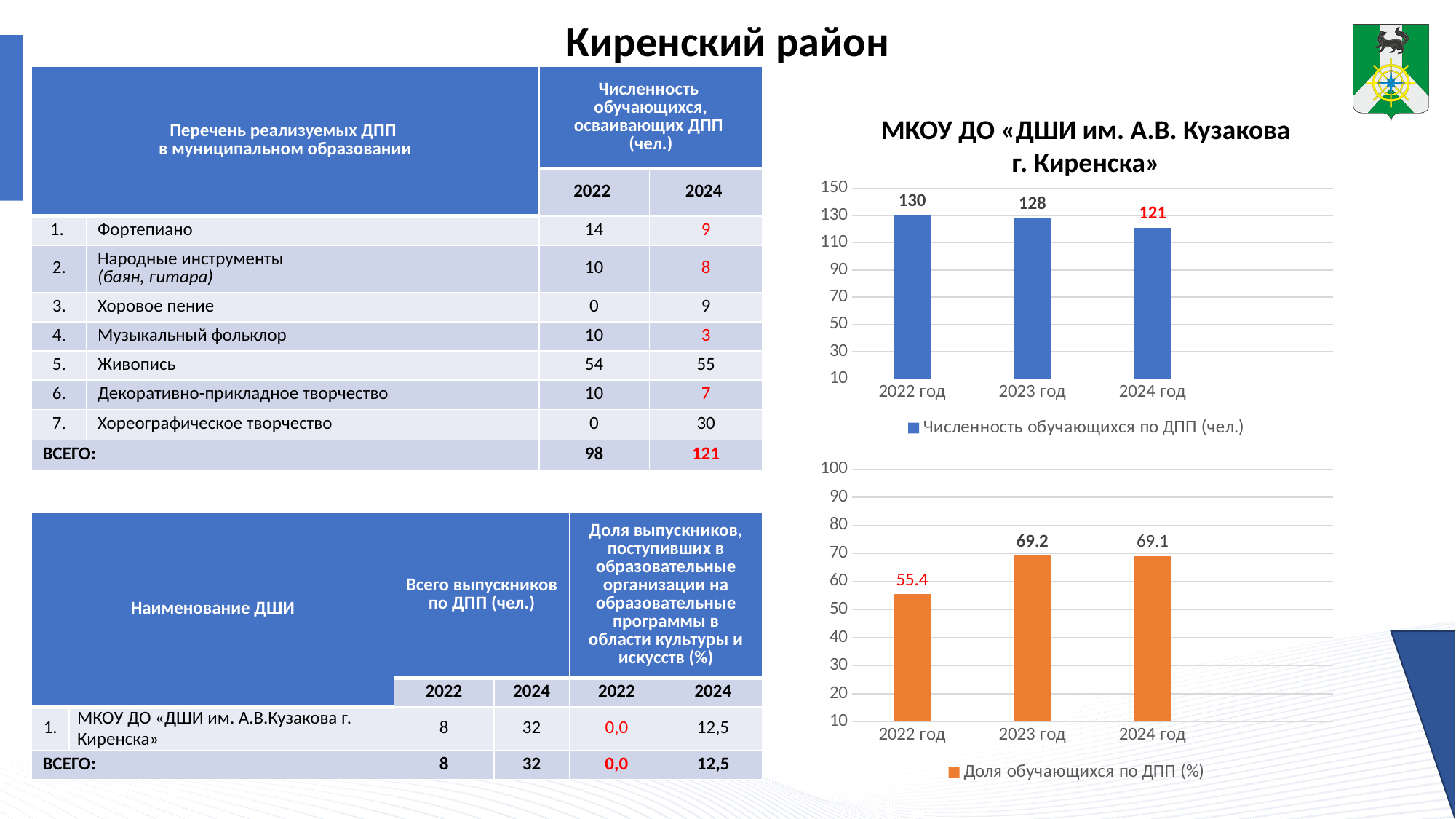
In the top chart, what is the difference between the values for 2022 год and 2024 год? 9 In the bottom chart, what is the difference between the values for 2023 год and 2022 год? 13.8 In the bottom chart, what is the value for 2023 год? 69.2 In the top chart, which year has the lowest value? 2024 год In the top chart, what is the value for 2022 год? 130 In the top chart, do the values rise or fall from 2022 год to 2024 год? fall In the bottom chart, what is the value for 2022 год? 55.4 In the top chart, what is the value for 2024 год? 121 In the bottom chart, which year has the lowest value? 2022 год In the bottom chart, is the value for 2022 год larger or smaller than the value for 2024 год? smaller What type of chart is the bottom chart? bar chart In the top chart, what series name does the legend show? Численность обучающихся по ДПП (чел.)